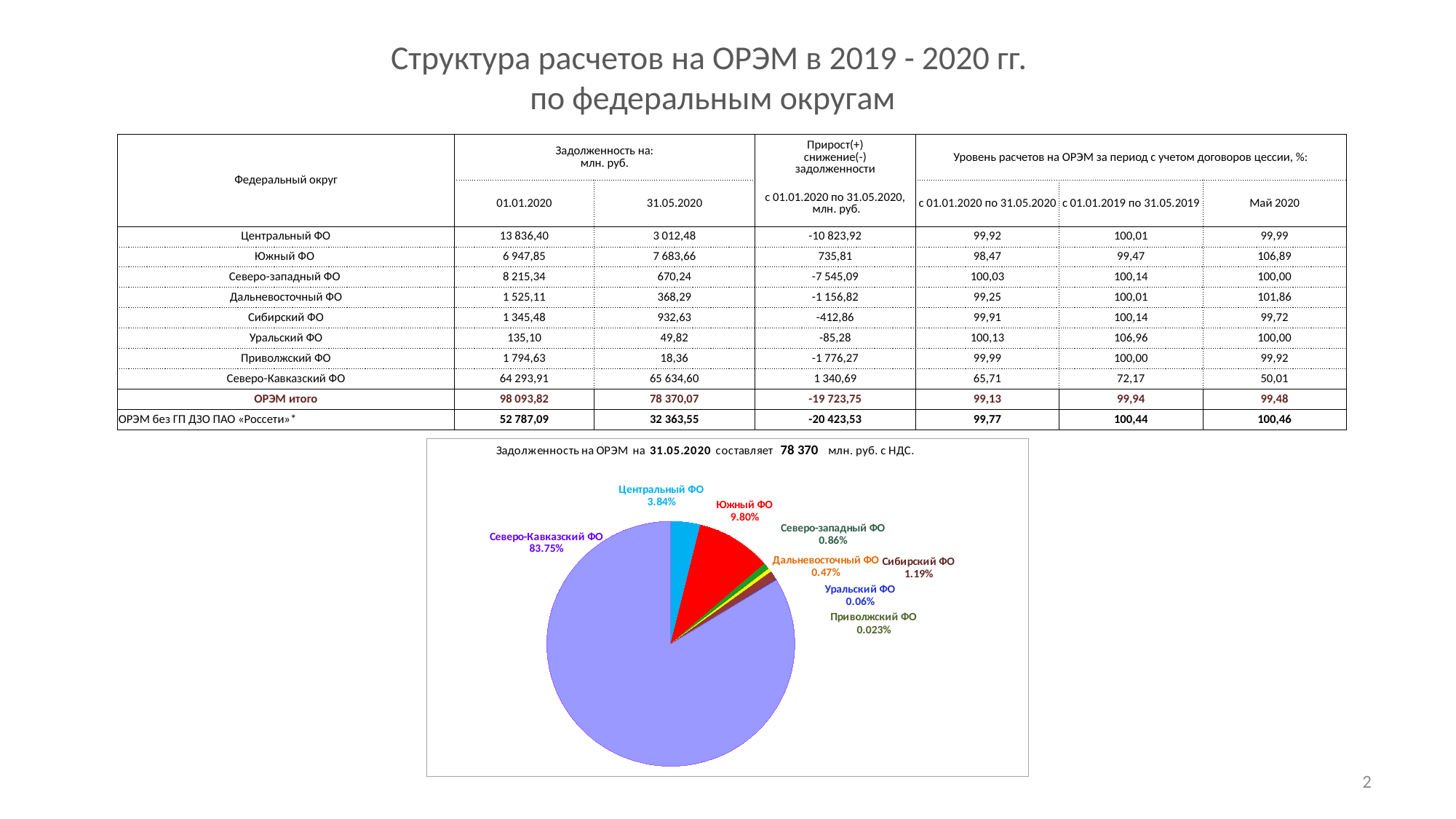
What share of the pie does Южный ФО hold? 9.80% What share of the pie does Центральный ФО hold? 3.84% Which federal district has the smallest slice of the pie? Приволжский ФО According to the chart title, what is the total debt on ОРЭМ as of 31.05.2020 in млн. руб.? 78 370 How many slices does the pie chart have? 8 What is the difference in percentage points between the Южный ФО and Центральный ФО slices? 5.96 What share of the pie does Приволжский ФО hold? 0.023% Which federal district has the largest slice of the pie? Северо-Кавказский ФО Which slice is larger: Южный ФО or Центральный ФО? Южный ФО What kind of chart is shown on the slide? pie chart